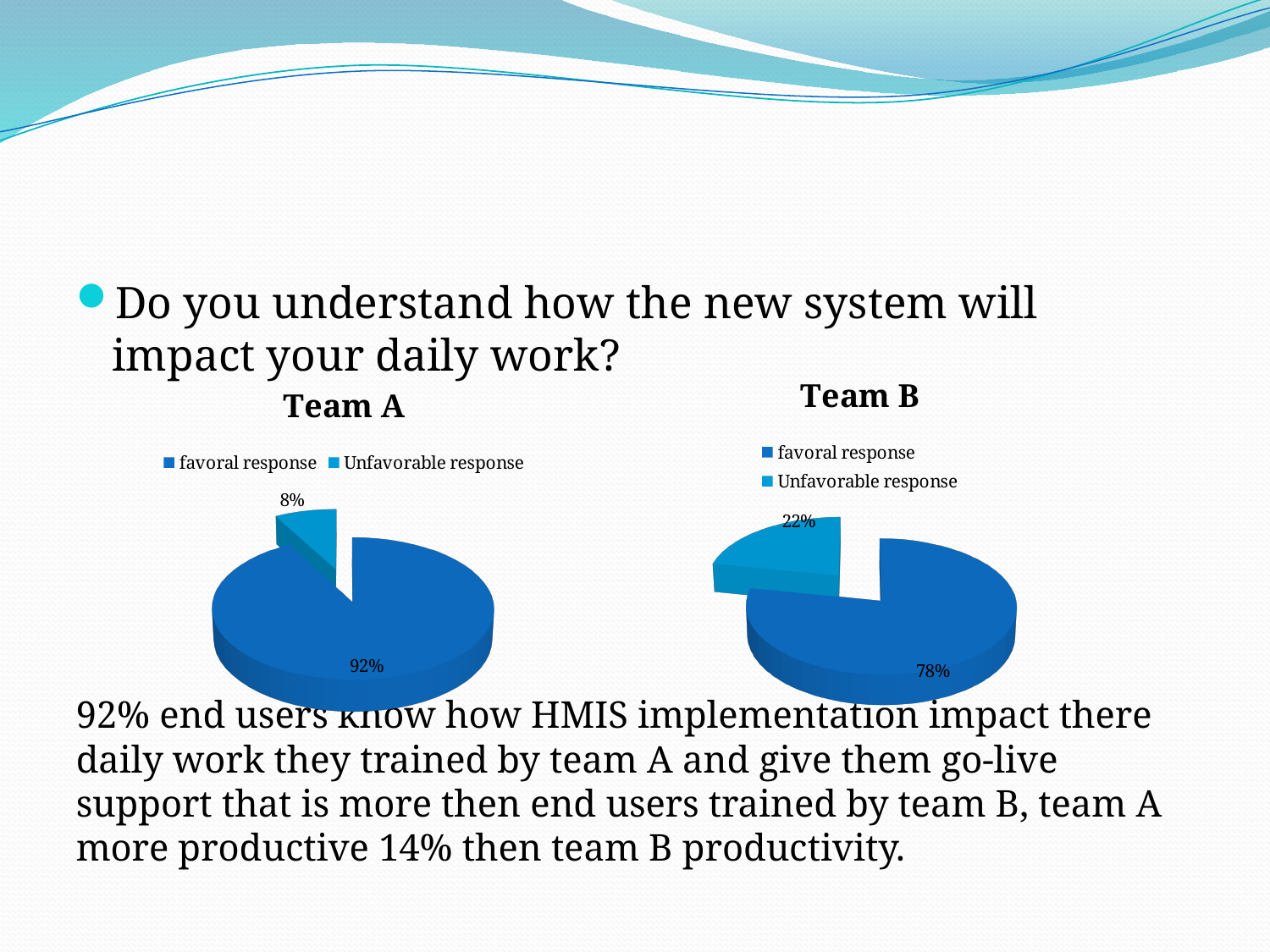
Which chart has the larger Unfavorable response share, Team A or Team B? Team B In the Team B chart, what percentage is the favoral response slice? 78% In the Team A chart, what percentage is the Unfavorable response slice? 8% In the Team B chart, which slice is the smallest? Unfavorable response What is the title of the chart on the right side of the slide? Team B In the Team A chart, which slice is the largest? favoral response In the Team B chart, what percentage is the Unfavorable response slice? 22% In the Team A chart, what percentage is the favoral response slice? 92% What type of chart is used for Team A? Pie chart How many slices does the Team A pie chart have? 2 What is the difference between the favoral response share in the Team A chart and the favoral response share in the Team B chart? 14% How many entries does the legend of the Team B chart list? 2